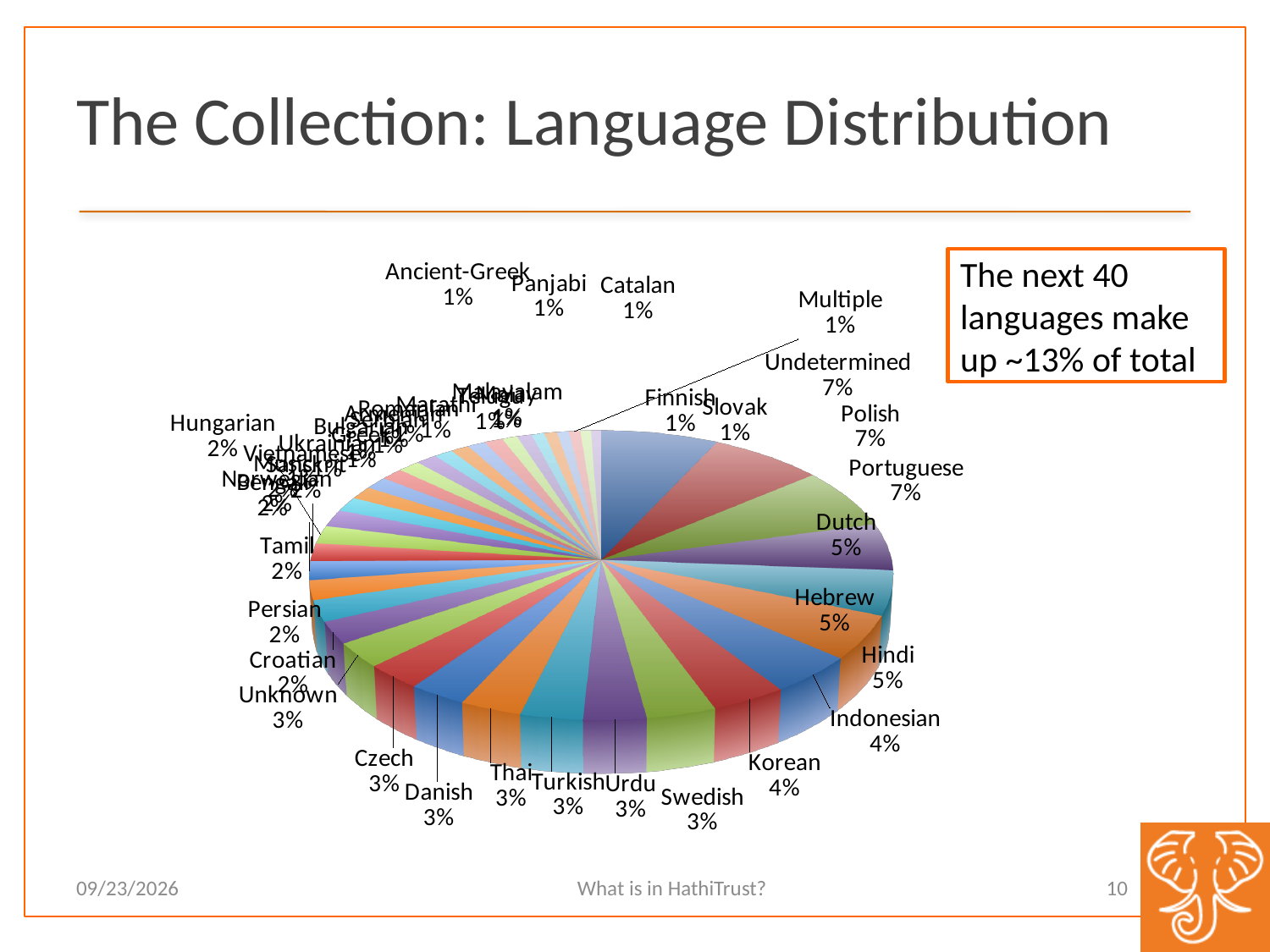
What percentage is labelled for Persian? 2% What is the title of the slide containing the chart? The Collection: Language Distribution What share is shown for Catalan? 1% Which has the larger share, Hebrew or Czech? Hebrew What share of the collection is labelled Undetermined? 7% What percentage is shown for Indonesian? 4% What share does Swedish have? 3% Which has the larger share, Portuguese or Korean? Portuguese What is the share for Dutch? 5% What percentage does Polish account for? 7% What kind of chart is shown on the slide? pie chart By how many percentage points does Undetermined exceed Hindi? 2